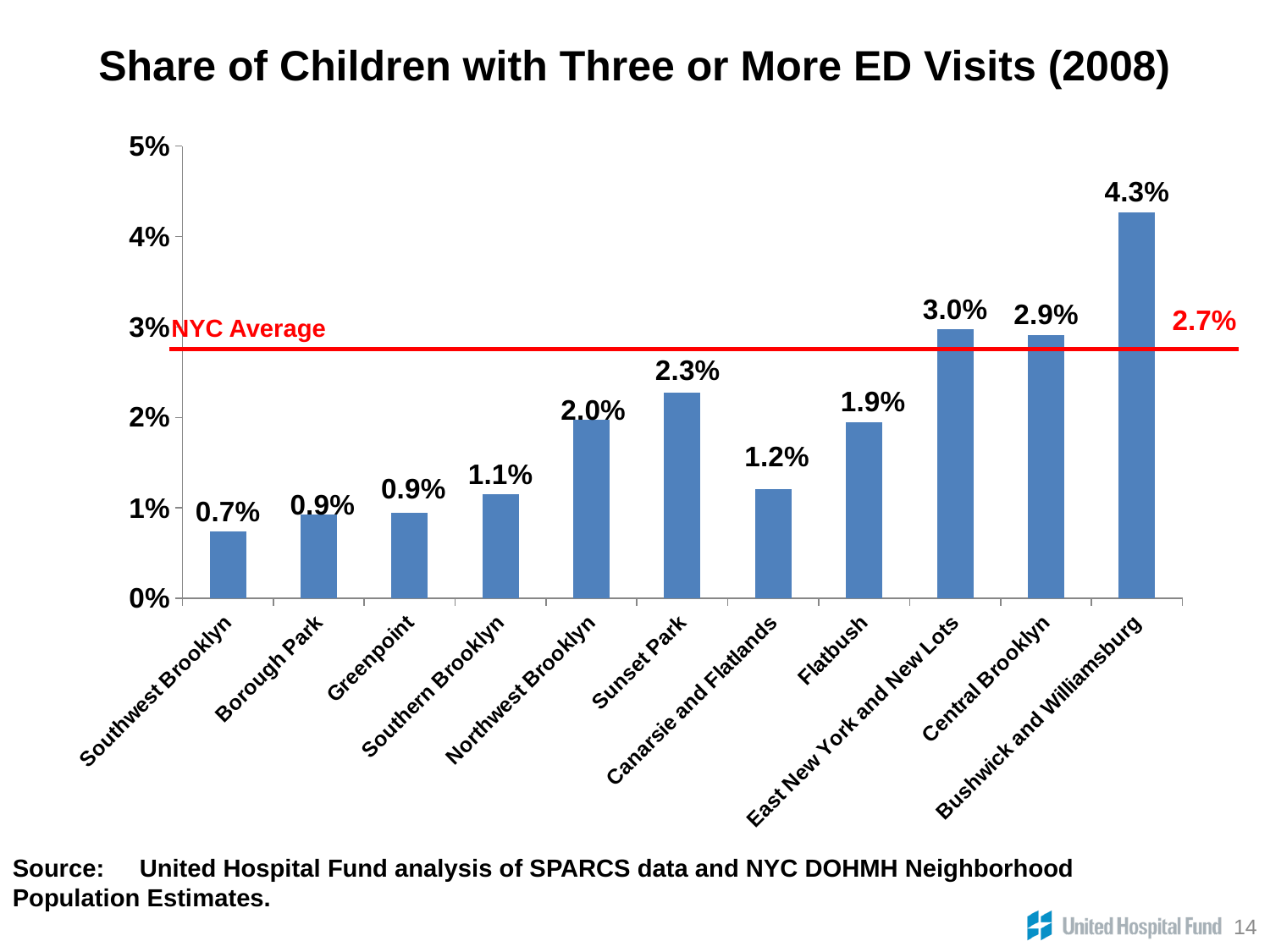
What is the difference between the values for Bushwick and Williamsburg and Central Brooklyn? 1.4% Is the value for Central Brooklyn greater or less than 2%? greater Which neighborhood has the highest share of children with three or more ED visits? Bushwick and Williamsburg What is the value shown for Flatbush? 1.9% What is the share of children with three or more ED visits in Sunset Park? 2.3% Which neighborhood has the lowest share of children with three or more ED visits? Southwest Brooklyn What is the NYC Average value marked by the red line? 2.7% What kind of chart is shown on the slide? Bar chart What is the value shown for East New York and New Lots? 3.0% Which has a higher value, Northwest Brooklyn or Canarsie and Flatlands? Northwest Brooklyn How many neighborhoods are shown on the chart? 11 What is the title of the chart? Share of Children with Three or More ED Visits (2008)